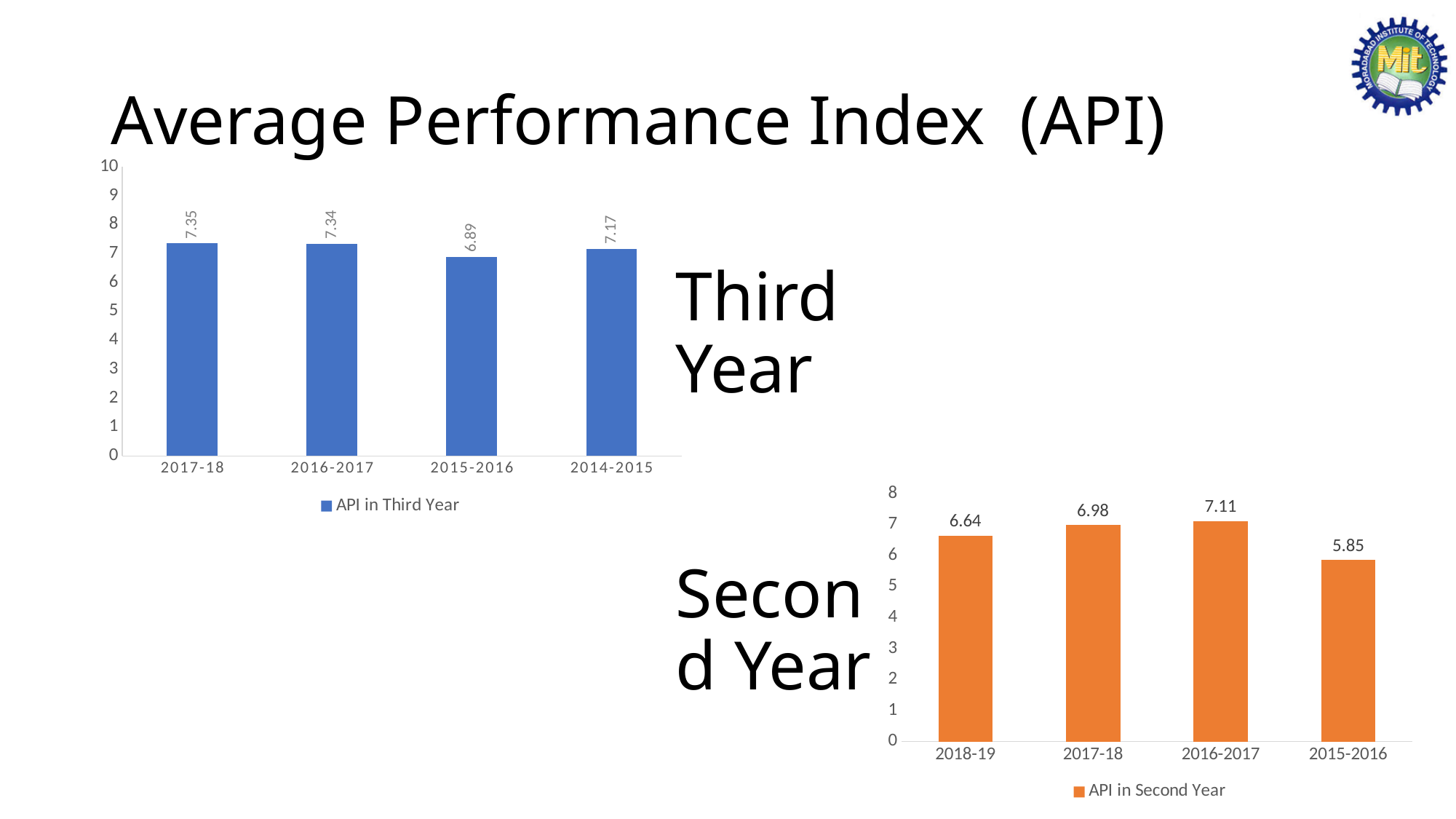
In the Second Year chart, what is the API value for 2016-2017? 7.11 In the Second Year chart, which year has the highest API? 2016-2017 In the Third Year chart, what is the API value for 2015-2016? 6.89 What is the legend entry of the Third Year chart? API in Third Year In the Third Year chart, how many years are shown? 4 In the Second Year chart, what is the API value for 2015-2016? 5.85 In the Second Year chart, what is the difference between the API for 2016-2017 and 2015-2016? 1.26 In the Third Year chart, what is the API value for 2017-18? 7.35 In the Second Year chart, is the API for 2018-19 or 2017-18 larger? 2017-18 In the Third Year chart, which year has the lowest API? 2015-2016 What type of chart is the Second Year chart? Bar chart In the Third Year chart, what is the difference between the API for 2017-18 and 2014-2015? 0.18